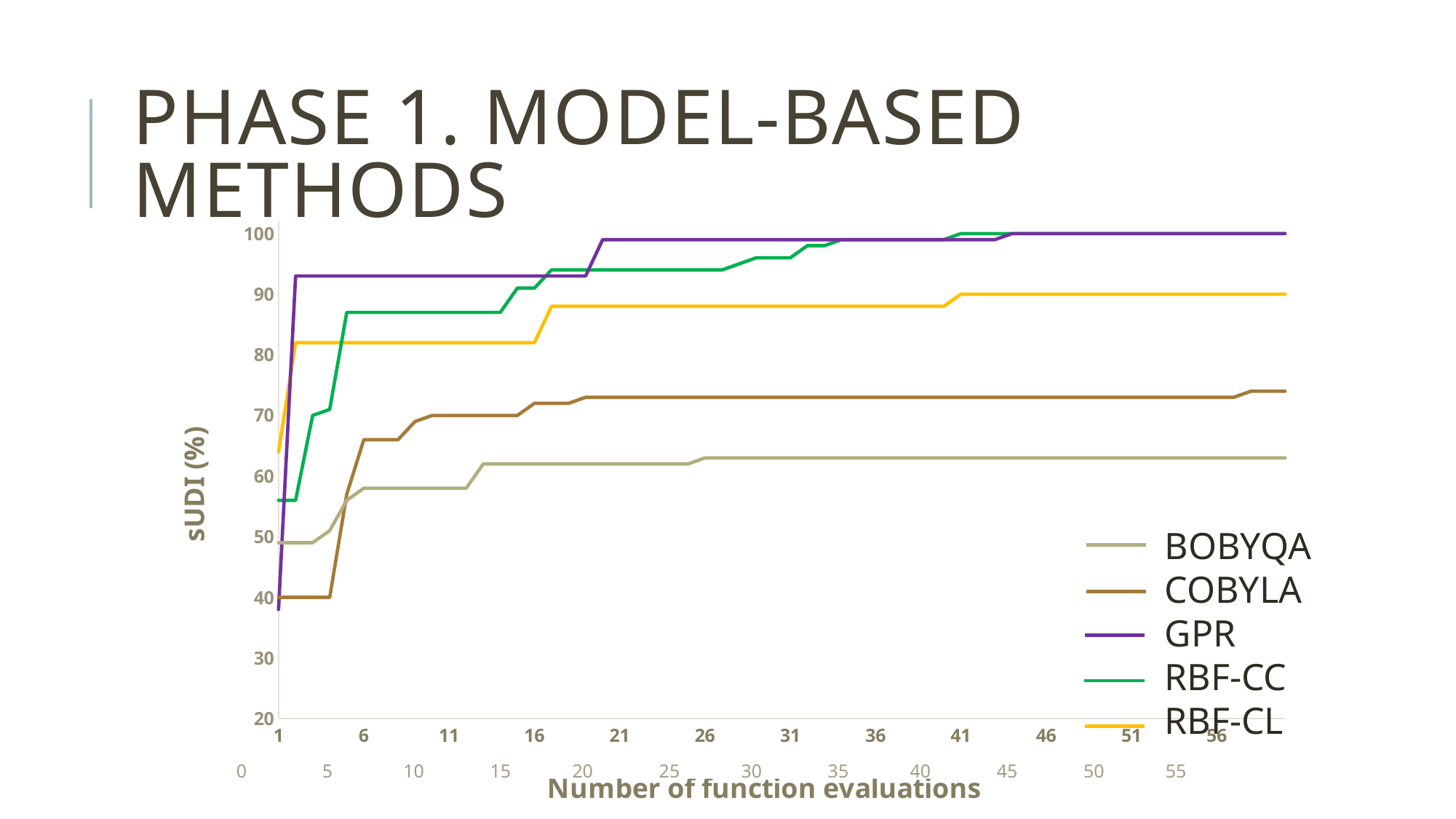
Is the value of the RBF-CC line at 6 function evaluations greater or less than 80? greater Is the final value of the COBYLA line greater or less than 70? greater What sUDI (%) value does the RBF-CL line reach at the right end of the chart? 90 Which series has the lowest sUDI (%) at the right end of the chart? BOBYQA Do the sUDI (%) values rise or fall as the number of function evaluations increases? rise What is the label of the y axis? sUDI (%) How many series does the legend list? 5 What is the title of the x axis? Number of function evaluations What kind of chart is shown on the slide? line chart At the right end of the chart, which is higher: GPR or COBYLA? GPR What sUDI (%) value does the GPR line reach at the right end of the chart? 100 Is the final value of the BOBYQA line greater or less than 70? less